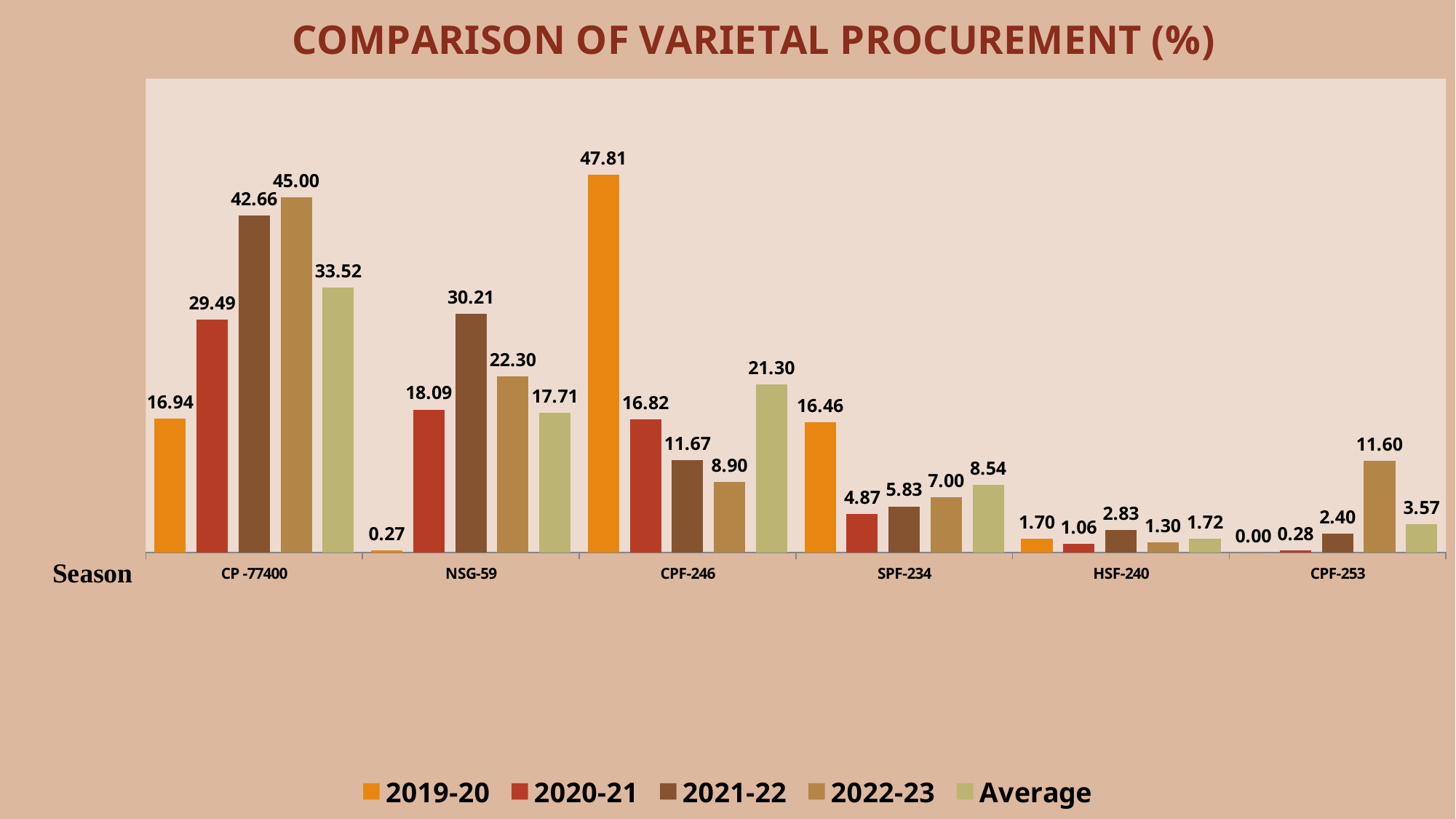
Which variety has the highest Average value? CP -77400 What is the difference between the 2022-23 and 2021-22 values for CP -77400? 2.34 How many varieties are shown on the x axis? 6 What is the title of the chart? COMPARISON OF VARIETAL PROCUREMENT (%) What kind of chart is shown? bar chart What is the Average value for NSG-59? 17.71 What is the value for CPF-246 in the 2019-20 series? 47.81 What is the value for CP -77400 in the 2022-23 series? 45.00 What is the value for CPF-253 in the 2019-20 series? 0.00 Which variety has the lowest value in the 2021-22 series? CPF-253 How many series does the legend list? 5 Which is larger for NSG-59: the 2020-21 value or the 2022-23 value? 2022-23